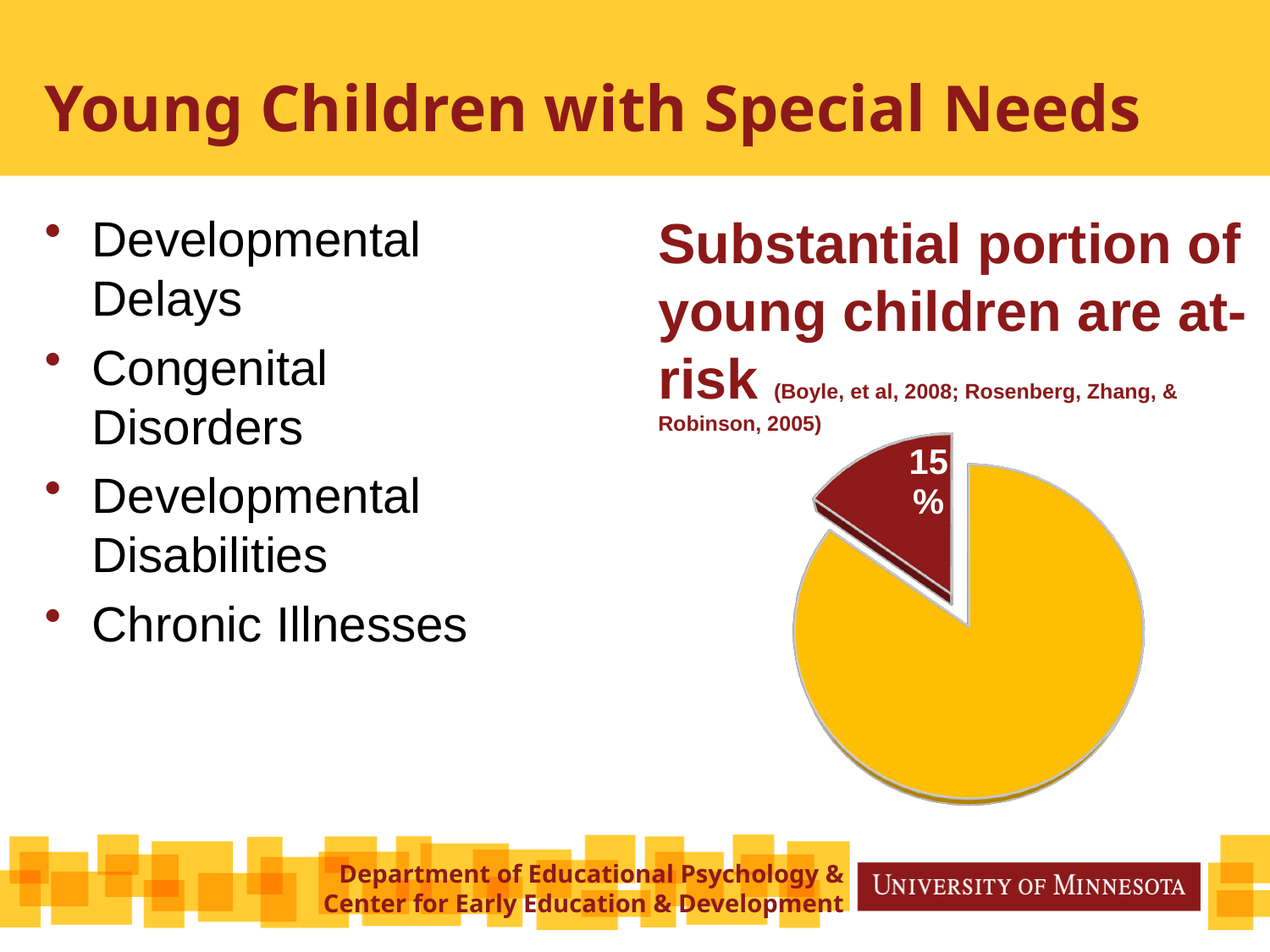
Does the pie chart include a legend? No What share of the pie does the dark red slice represent? 15% Which slice takes up the smallest portion of the pie chart? the dark red slice How many slices does the pie chart have? 2 Which slice of the pie chart is larger, the yellow one or the dark red one? the yellow one Is the dark red slice of the pie chart greater or less than half of the pie? less What kind of chart is shown on the slide? pie chart What value is printed on the dark red slice of the pie chart? 15% What colour is the slice labelled 15% in the pie chart? dark red Which slice takes up the largest portion of the pie chart? the yellow slice